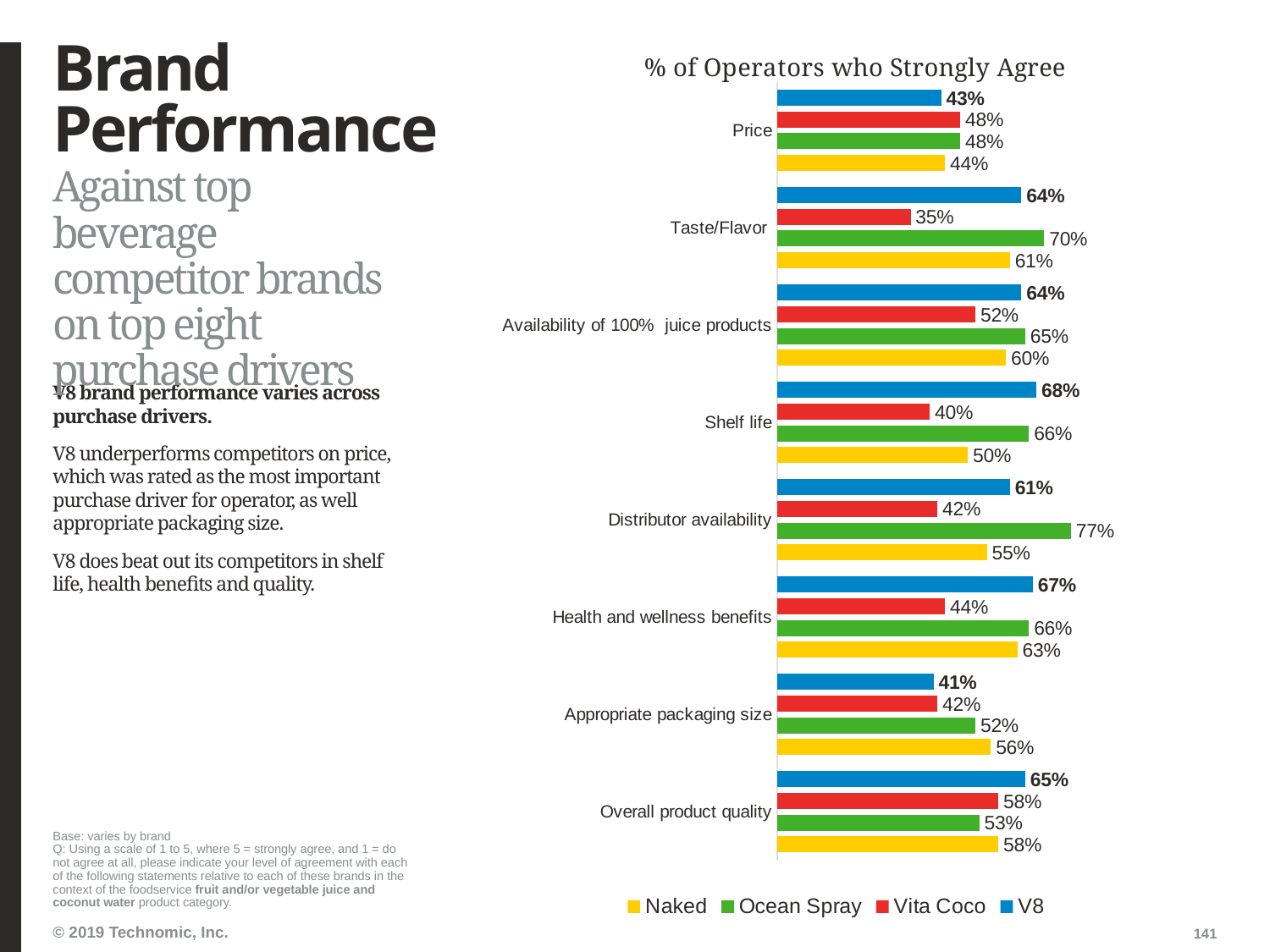
What is the difference between Ocean Spray and Vita Coco on Taste/Flavor? 35% What is the value for V8 on Shelf life? 68% What kind of chart is shown on the slide? Bar chart What is the value for Ocean Spray on Distributor availability? 77% How many series does the chart legend list? 4 Which is larger for Overall product quality: V8 or Ocean Spray? V8 What is the value for Vita Coco on Taste/Flavor? 35% Which brand has the highest value for Distributor availability? Ocean Spray Which brand has the lowest value for Shelf life? Vita Coco How many purchase driver categories are shown on the chart? 8 What is the title of the chart? % of Operators who Strongly Agree What is the value for Naked on Appropriate packaging size? 56%